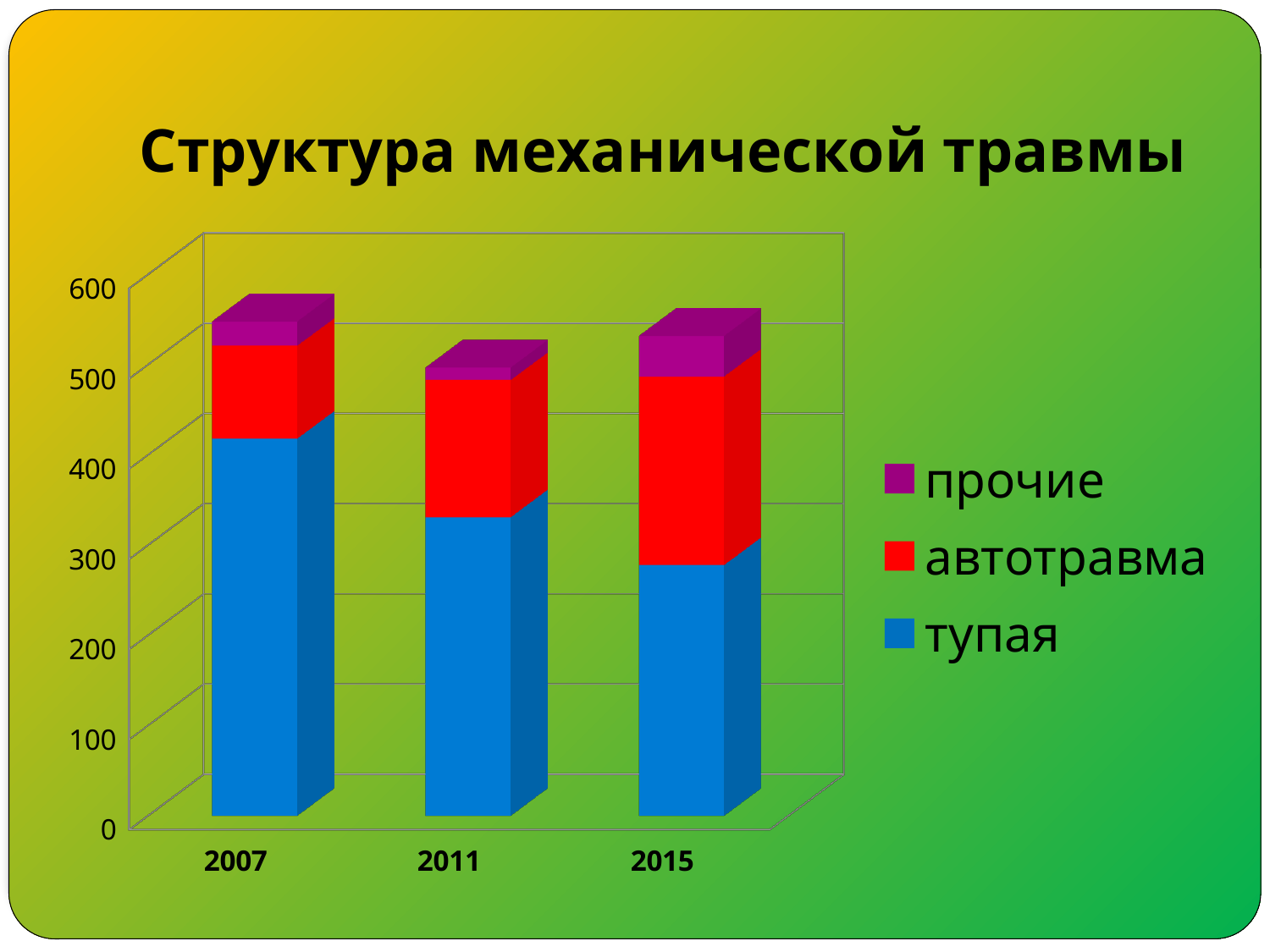
How many years are shown on the x axis? 3 Does the value for тупая rise or fall from 2007 to 2015? fall In which year is the value for тупая the lowest? 2015 Which series is shown in red? автотравма Is the value for тупая in 2015 greater or less than 400? less What is the title of the chart? Структура механической травмы In which year is the value for тупая the highest? 2007 How many series does the legend list? 3 Does the value for автотравма rise or fall from 2007 to 2015? rise Is the value for тупая in 2007 greater or less than 300? greater Which is larger, the value for автотравма in 2015 or in 2007? 2015 What type of chart is shown on the slide? bar chart